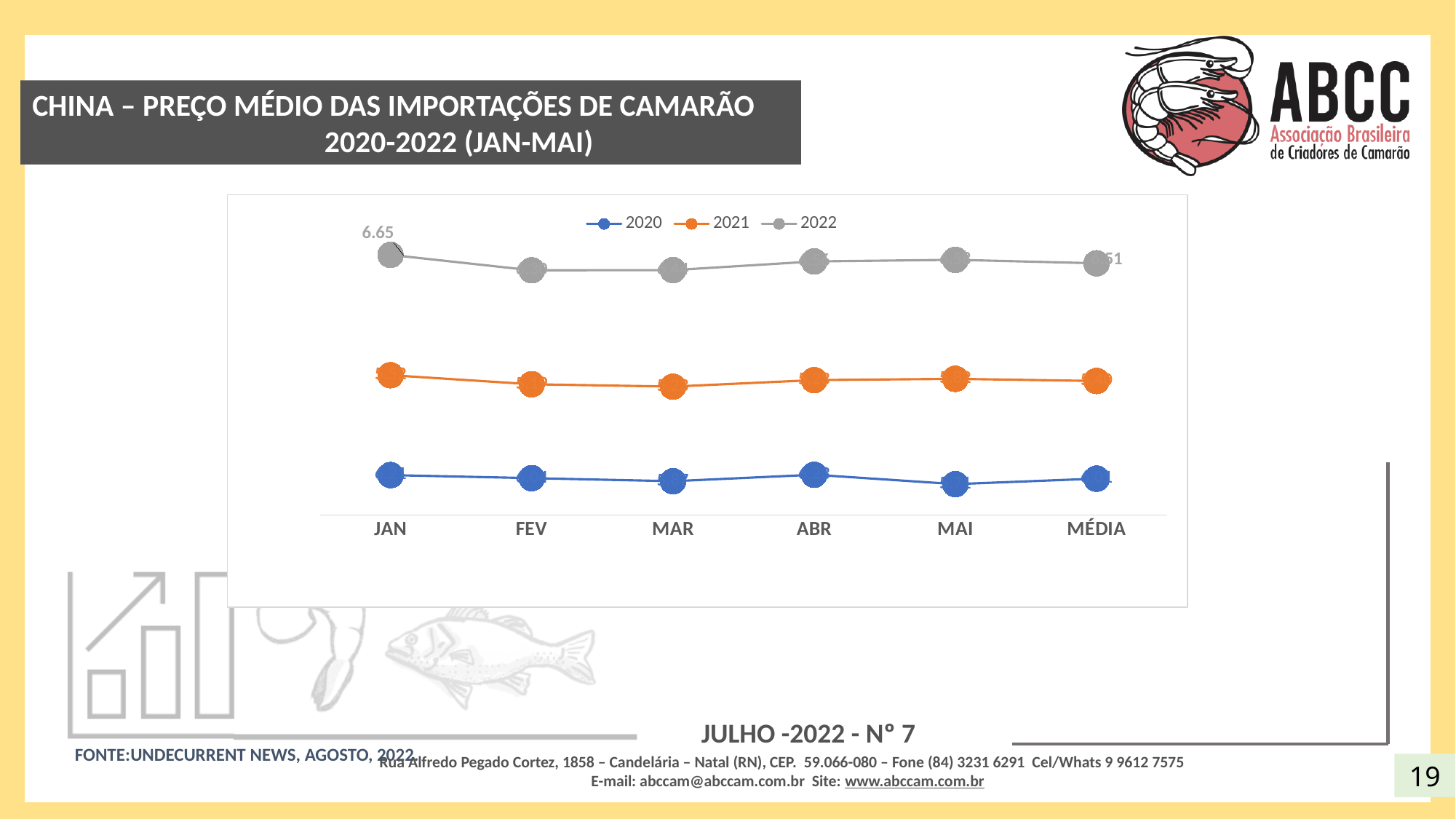
Which series has the highest values across all months? 2022 What is the title of the slide's chart? CHINA – PREÇO MÉDIO DAS IMPORTAÇÕES DE CAMARÃO 2020-2022 (JAN-MAI) How many categories are shown along the x axis? 6 What is the value for 2022 in JAN? 6.65 What colour is the line for the 2021 series? orange In JAN, which is larger: the value for 2022 or the value for 2020? 2022 How many series does the legend list? 3 What kind of chart is shown on the slide? line chart Does the 2022 line rise or fall from JAN to FEV? fall